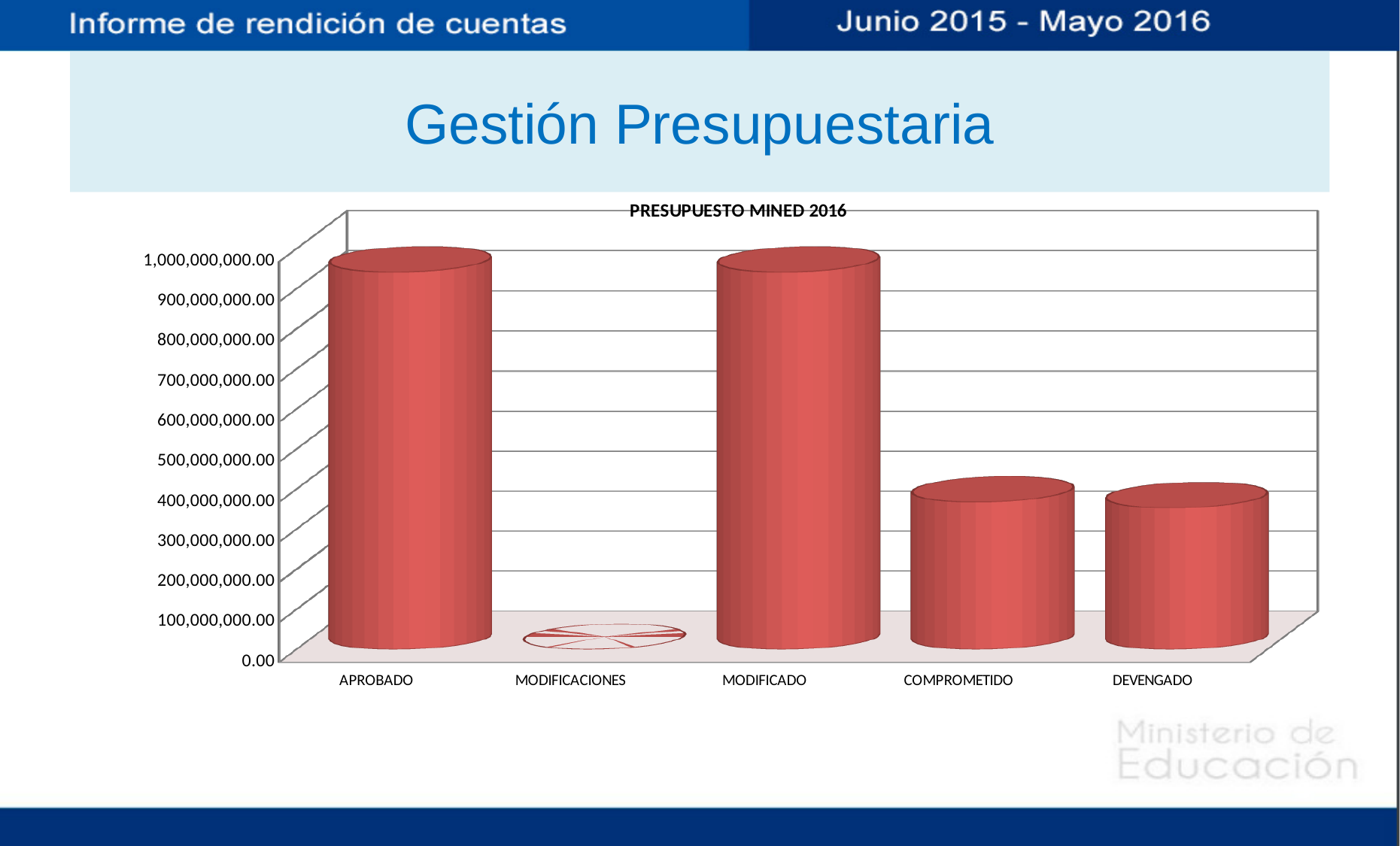
What colour are the bars in the chart? Red Is the value for MODIFICACIONES greater or less than 100,000,000.00? less How many categories are shown on the x axis of the chart? 5 What kind of chart is shown on the slide? Bar chart Is the value for MODIFICADO greater or less than 900,000,000.00? greater Which category has the lowest value in the chart? MODIFICACIONES Which is larger, the value for APROBADO or the value for COMPROMETIDO? APROBADO Is the value for DEVENGADO greater or less than 300,000,000.00? greater What is the title of the chart? PRESUPUESTO MINED 2016